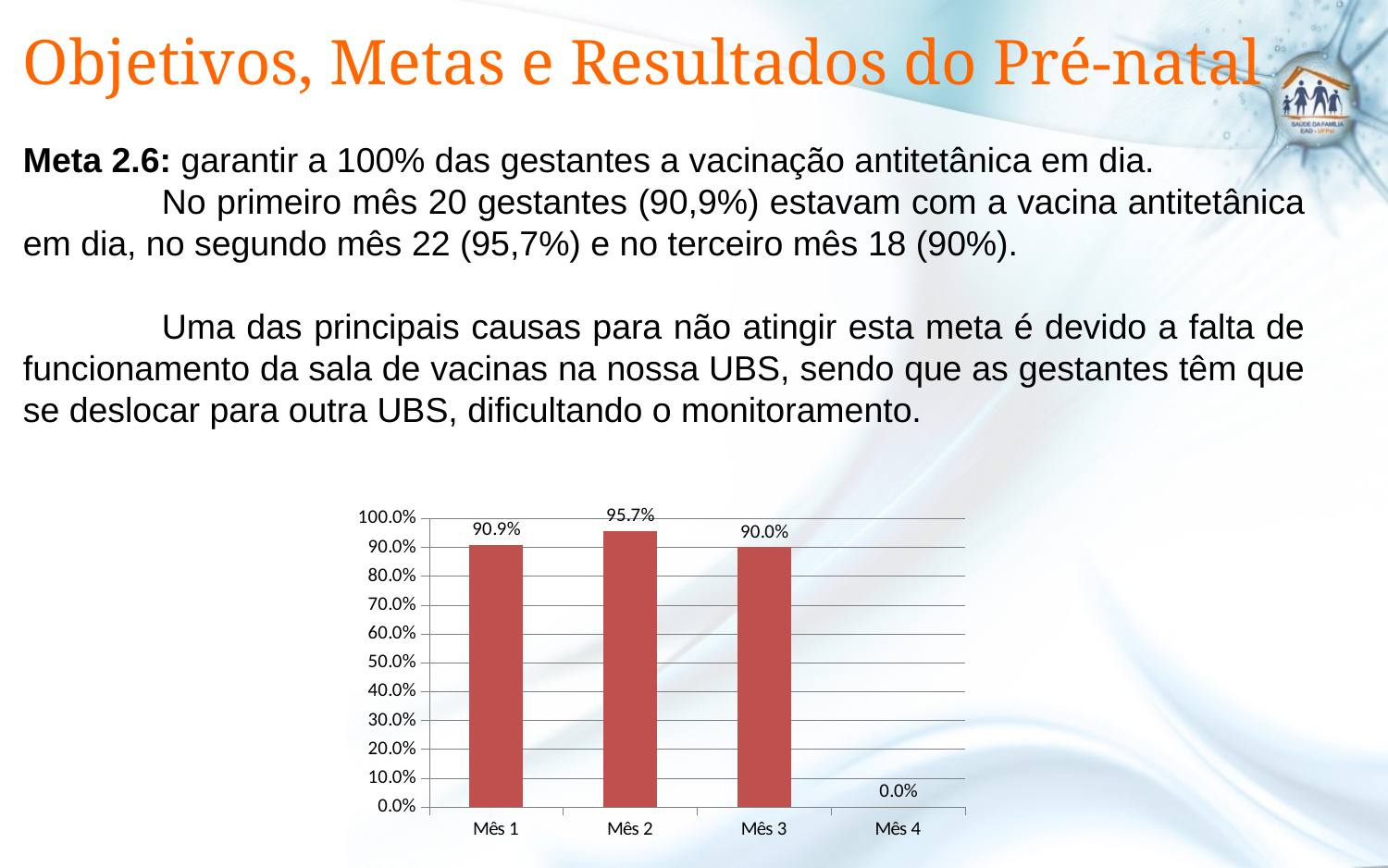
What is the value for Mês 3? 90.0% What is the value for Mês 1? 90.9% Which month has the highest value? Mês 2 Which is larger, the value for Mês 1 or the value for Mês 3? Mês 1 What is the value for Mês 4? 0.0% What is the value for Mês 2? 95.7% Which month has the lowest value? Mês 4 How many categories are shown on the x axis? 4 What is the maximum value shown on the y axis? 100.0% What kind of chart is shown on the slide? bar chart What is the difference between the values for Mês 2 and Mês 1? 4.8% Is the value for Mês 2 greater or less than 90.0%? greater